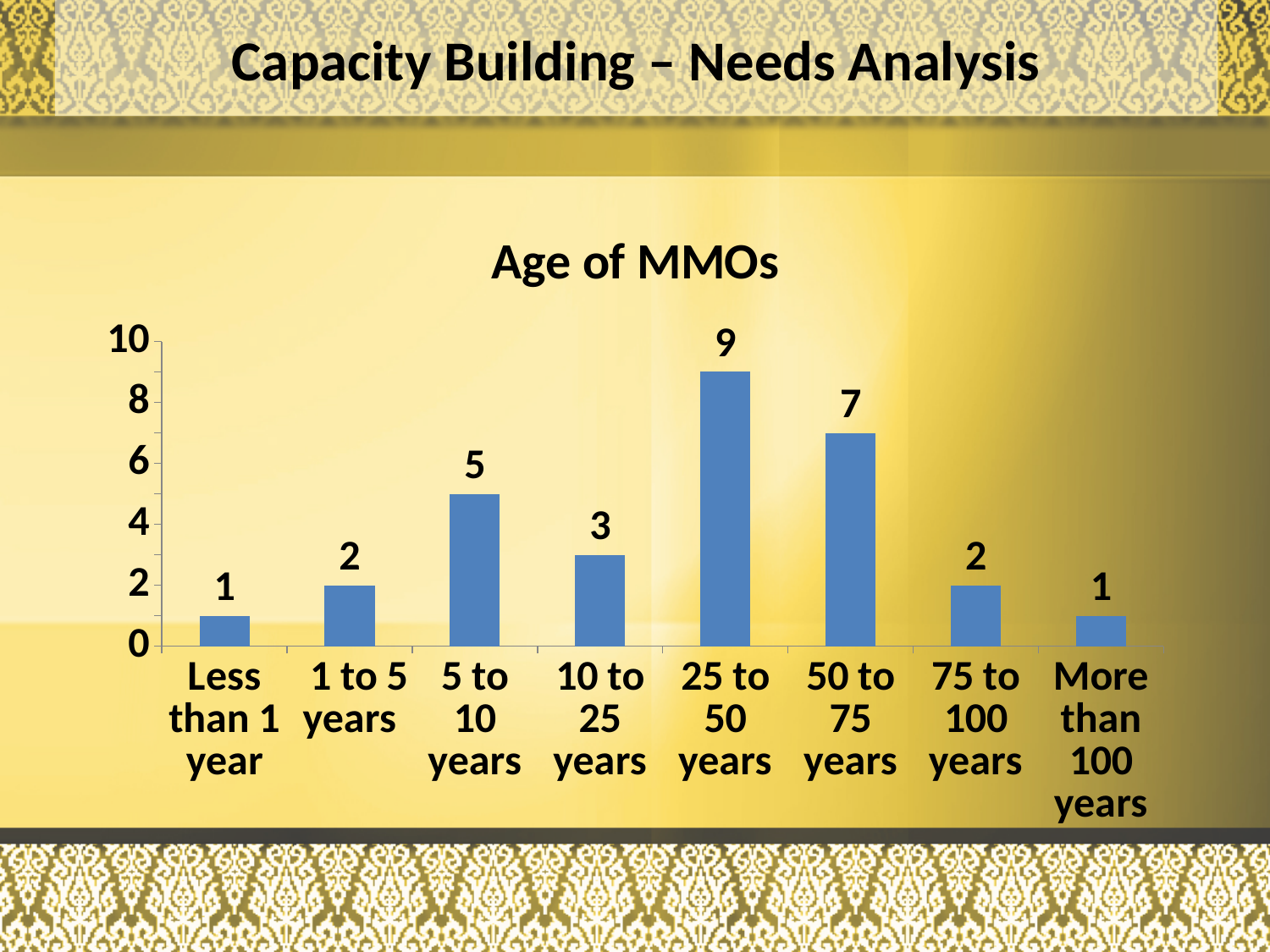
What is the difference between the values for 25 to 50 years and 50 to 75 years? 2 Which category has the highest value? 25 to 50 years What is the value for the 5 to 10 years category? 5 What is the value for the 25 to 50 years category? 9 Which is larger, the value for 5 to 10 years or the value for 10 to 25 years? 5 to 10 years How many categories are shown on the x axis? 8 What kind of chart is shown on the slide? bar chart Is the value for 50 to 75 years greater or less than 6? greater What is the value for the 10 to 25 years category? 3 What is the title of the chart? Age of MMOs What is the value for the More than 100 years category? 1 What is the difference between the values for 5 to 10 years and 1 to 5 years? 3